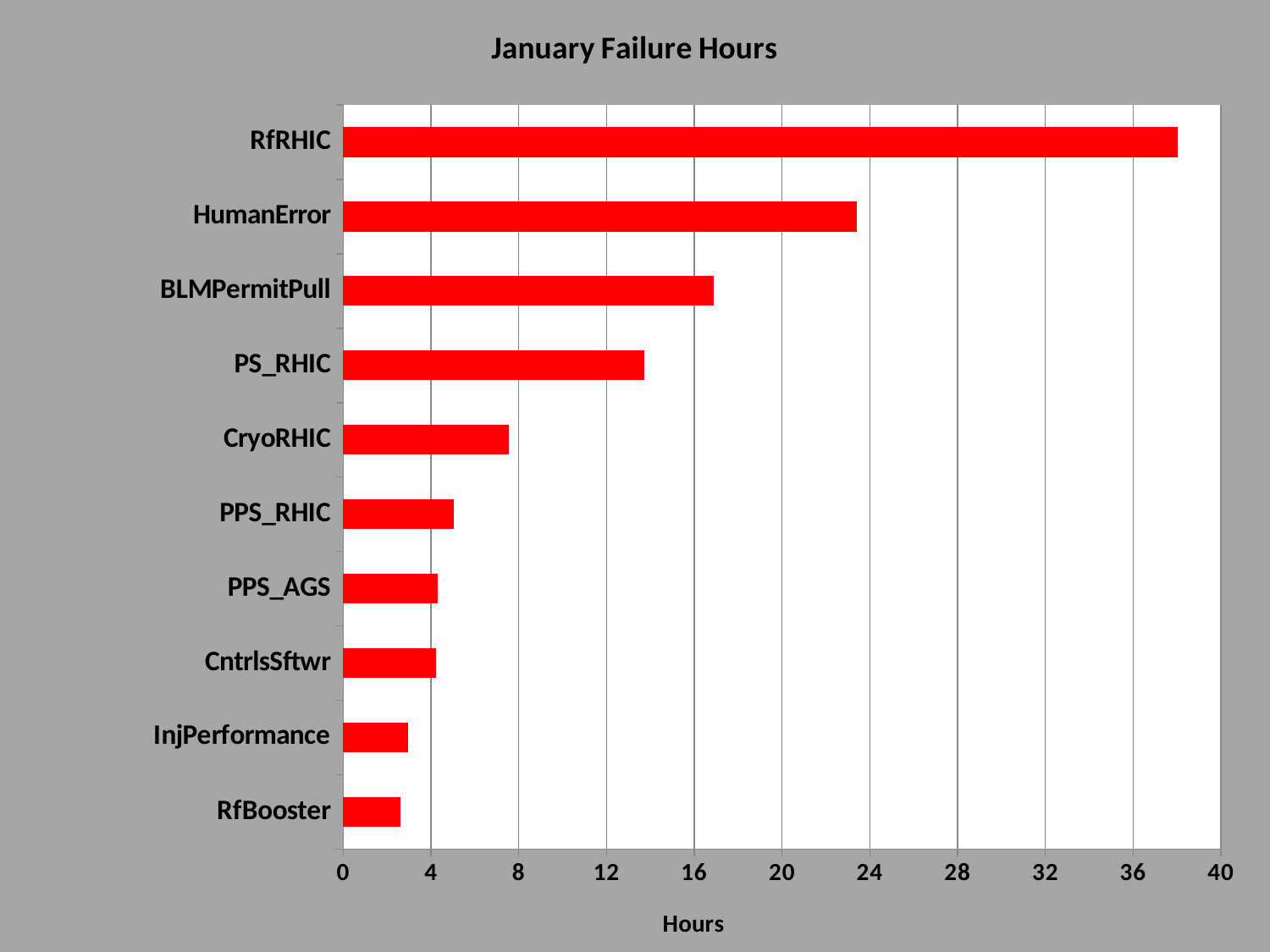
Is the value for InjPerformance greater or less than 4? less Is the value for RfRHIC greater or less than 36? greater How many categories are plotted in the chart? 10 What is the label on the horizontal axis? Hours Which category has the highest failure hours? RfRHIC Is the value for PS_RHIC greater or less than 12? greater Which has more failure hours, HumanError or BLMPermitPull? HumanError What kind of chart is shown on the slide? bar chart What is the title of the chart? January Failure Hours